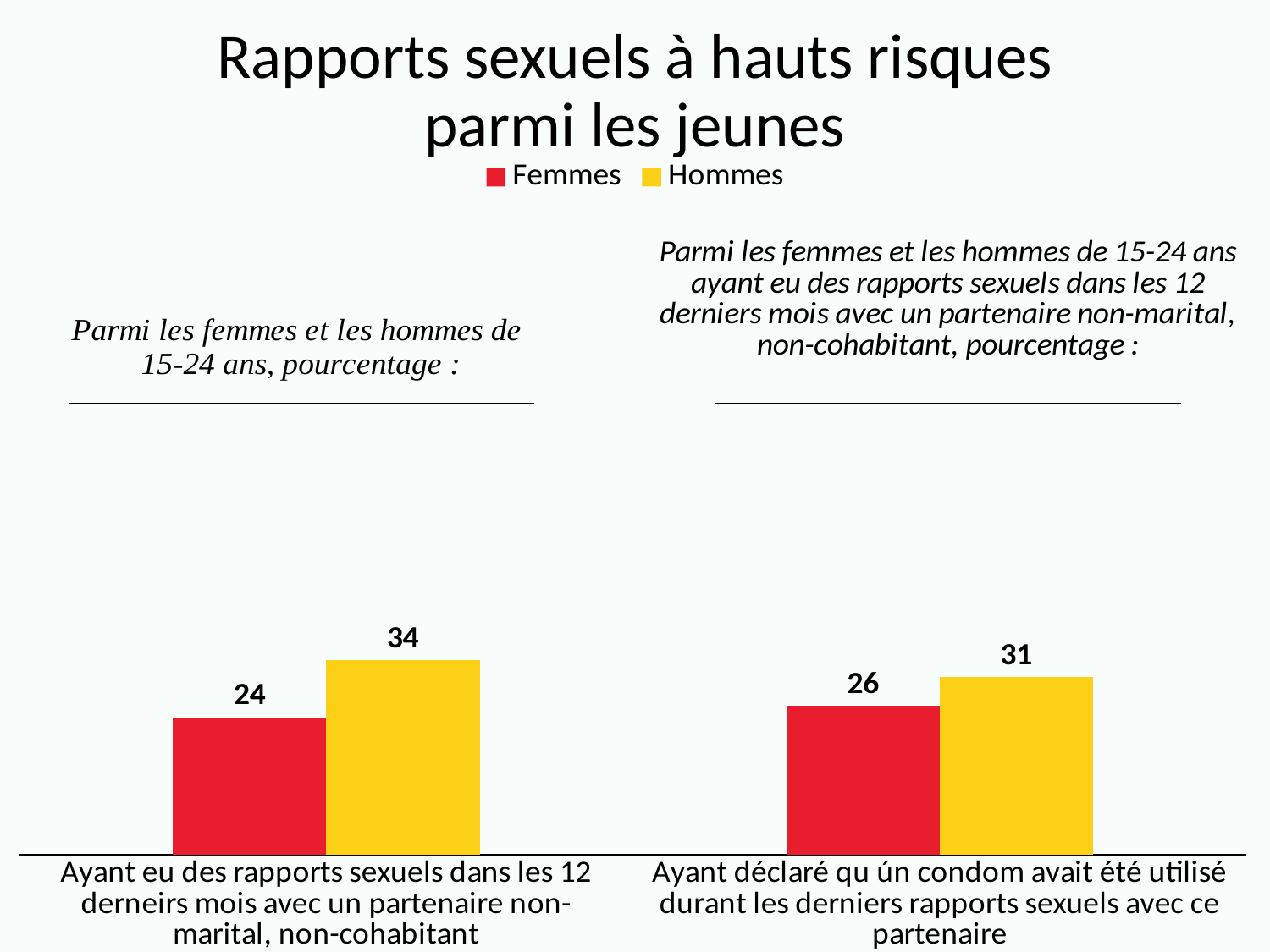
What is the difference between Hommes and Femmes in the category 'Ayant eu des rapports sexuels dans les 12 derneirs mois avec un partenaire non-marital, non-cohabitant'? 10 How many series does the legend list? 2 Which series has the highest value on the chart? Hommes What is the difference between Hommes and Femmes in the category 'Ayant déclaré qu ún condom avait été utilisé durant les derniers rapports sexuels avec ce partenaire'? 5 What kind of chart is shown on the slide? Bar chart What is the value for Hommes in the category 'Ayant eu des rapports sexuels dans les 12 derneirs mois avec un partenaire non-marital, non-cohabitant'? 34 What is the value for Femmes in the category 'Ayant eu des rapports sexuels dans les 12 derneirs mois avec un partenaire non-marital, non-cohabitant'? 24 Which series has the lowest value on the chart? Femmes What is the value for Hommes in the category 'Ayant déclaré qu ún condom avait été utilisé durant les derniers rapports sexuels avec ce partenaire'? 31 How many categories are shown on the x axis of the chart? 2 Which is larger: the Femmes value for condom use at last sex, or the Femmes value for sex with a non-marital, non-cohabiting partner? Condom use at last sex (26) What is the value for Femmes in the category 'Ayant déclaré qu ún condom avait été utilisé durant les derniers rapports sexuels avec ce partenaire'? 26